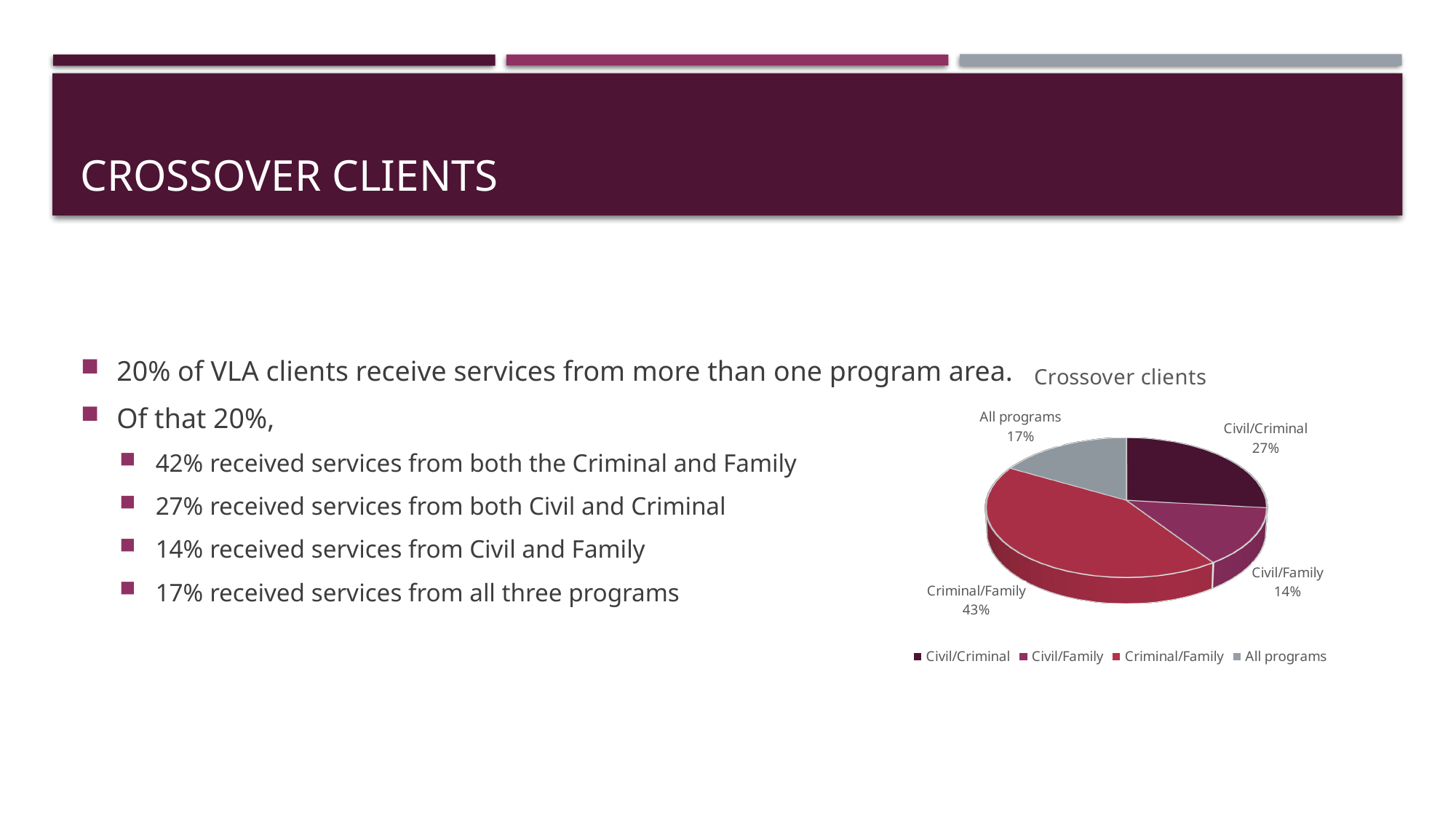
What is the difference between the Criminal/Family and Civil/Criminal percentages in the pie chart? 16% What percentage does the Criminal/Family slice show in the pie chart? 43% Which is larger in the pie chart, All programs or Civil/Family? All programs What percentage does the Civil/Criminal slice show in the pie chart? 27% What percentage does the Civil/Family slice show in the pie chart? 14% What is the title of the pie chart? Crossover clients Which category has the largest slice in the pie chart? Criminal/Family How many entries does the legend of the pie chart list? 4 What percentage does the All programs slice show in the pie chart? 17% How many slices does the pie chart have? 4 Which category has the smallest slice in the pie chart? Civil/Family What kind of chart is shown on the slide? pie chart